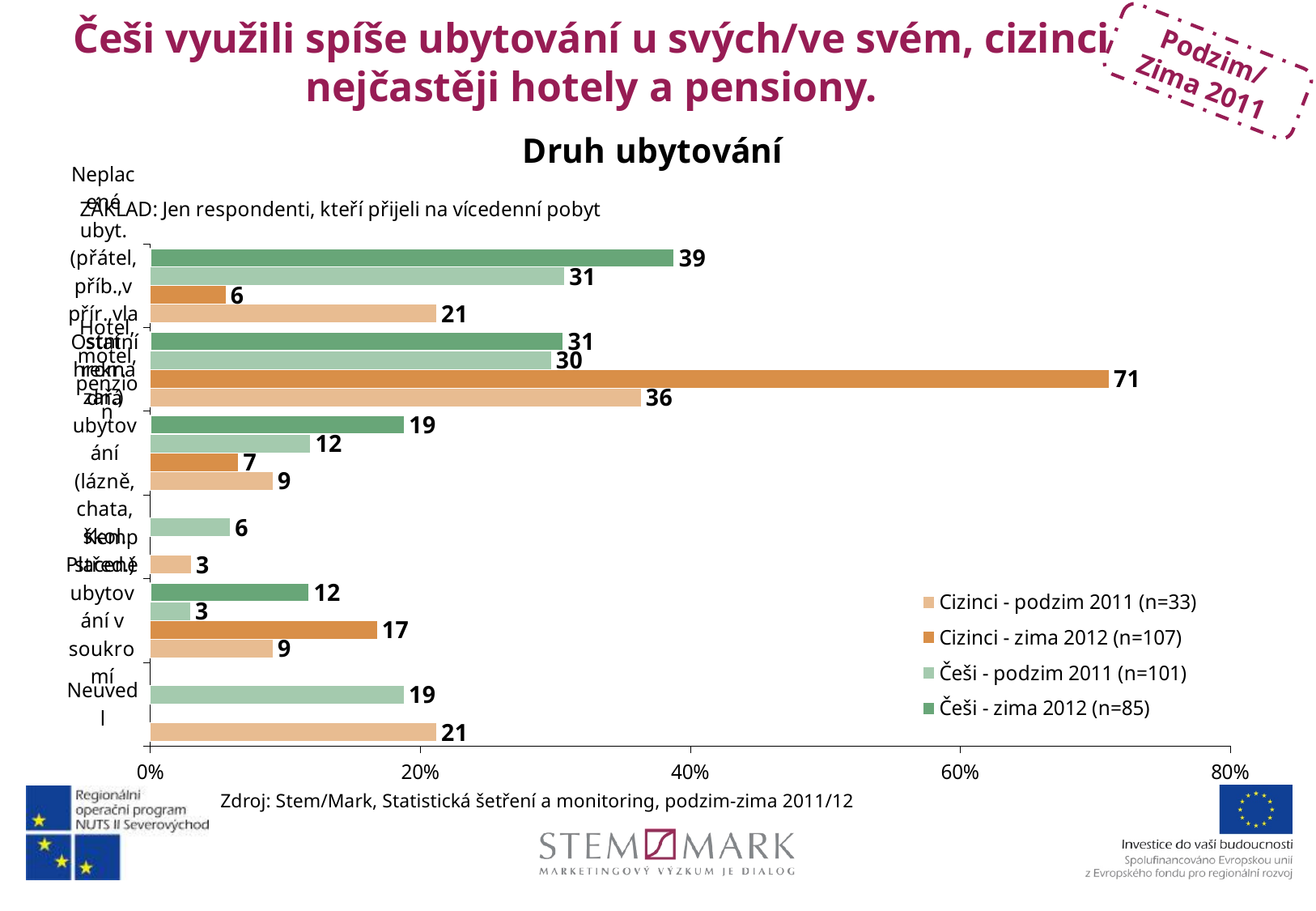
What kind of chart is shown under the title 'Druh ubytování'? bar chart In the topmost category of the chart, what is the value for the 'Češi - zima 2012' series? 39 According to the legend, what is the sample size (n) for the 'Češi - zima 2012' series? n=85 What is the difference between the 'Cizinci - podzim 2011' and 'Češi - podzim 2011' values for 'Neuvedl'? 2 What is the value for 'Neuvedl' in the 'Cizinci - podzim 2011' series? 21 What is the value for 'Neuvedl' in the 'Češi - podzim 2011' series? 19 In the topmost category of the chart, what is the difference between the 'Češi - zima 2012' value (39) and the 'Češi - podzim 2011' value (31)? 8 Is the longest bar on the chart (71) greater or less than 60%? greater In the topmost category of the chart, which is larger: the 'Češi - zima 2012' value or the 'Cizinci - zima 2012' value? Češi - zima 2012 What is the highest value shown on the 'Druh ubytování' chart? 71 How many series does the legend of the 'Druh ubytování' chart list? 4 Which series has the longest bar on the 'Druh ubytování' chart? Cizinci - zima 2012 (n=107)